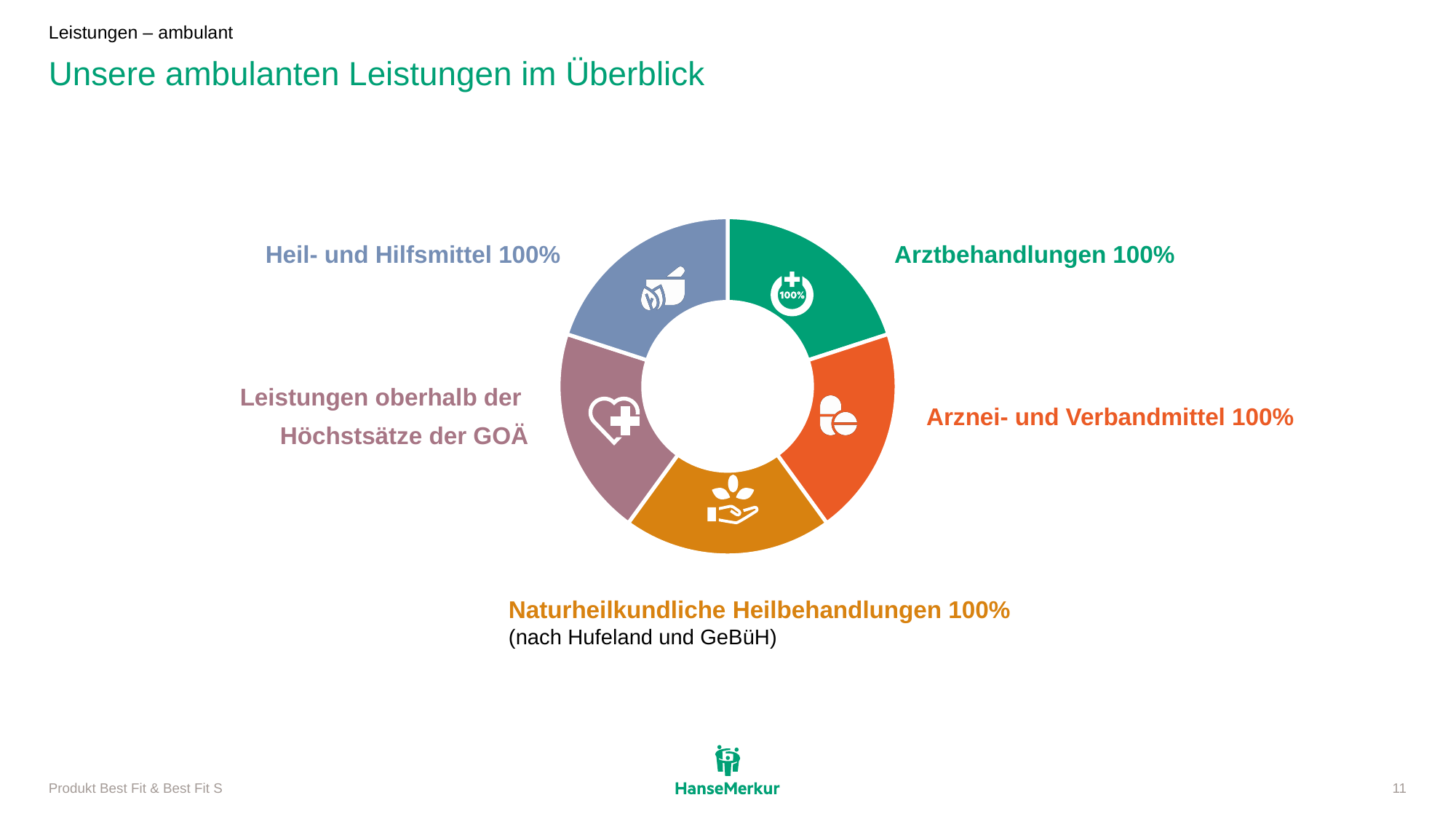
How many segments does the donut chart have? 5 What kind of chart is shown on the slide? Donut chart Which segment label does not show a percentage? Leistungen oberhalb der Höchstsätze der GOÄ What percentage is shown for Naturheilkundliche Heilbehandlungen? 100% Is the value for Arztbehandlungen larger than, smaller than, or equal to the value for Heil- und Hilfsmittel? Equal What percentage is shown for Arznei- und Verbandmittel? 100% What percentage is shown for Heil- und Hilfsmittel? 100% What colour is the Arztbehandlungen segment of the donut chart? Green What is the title of the slide containing the donut chart? Unsere ambulanten Leistungen im Überblick What percentage is shown for Arztbehandlungen? 100%